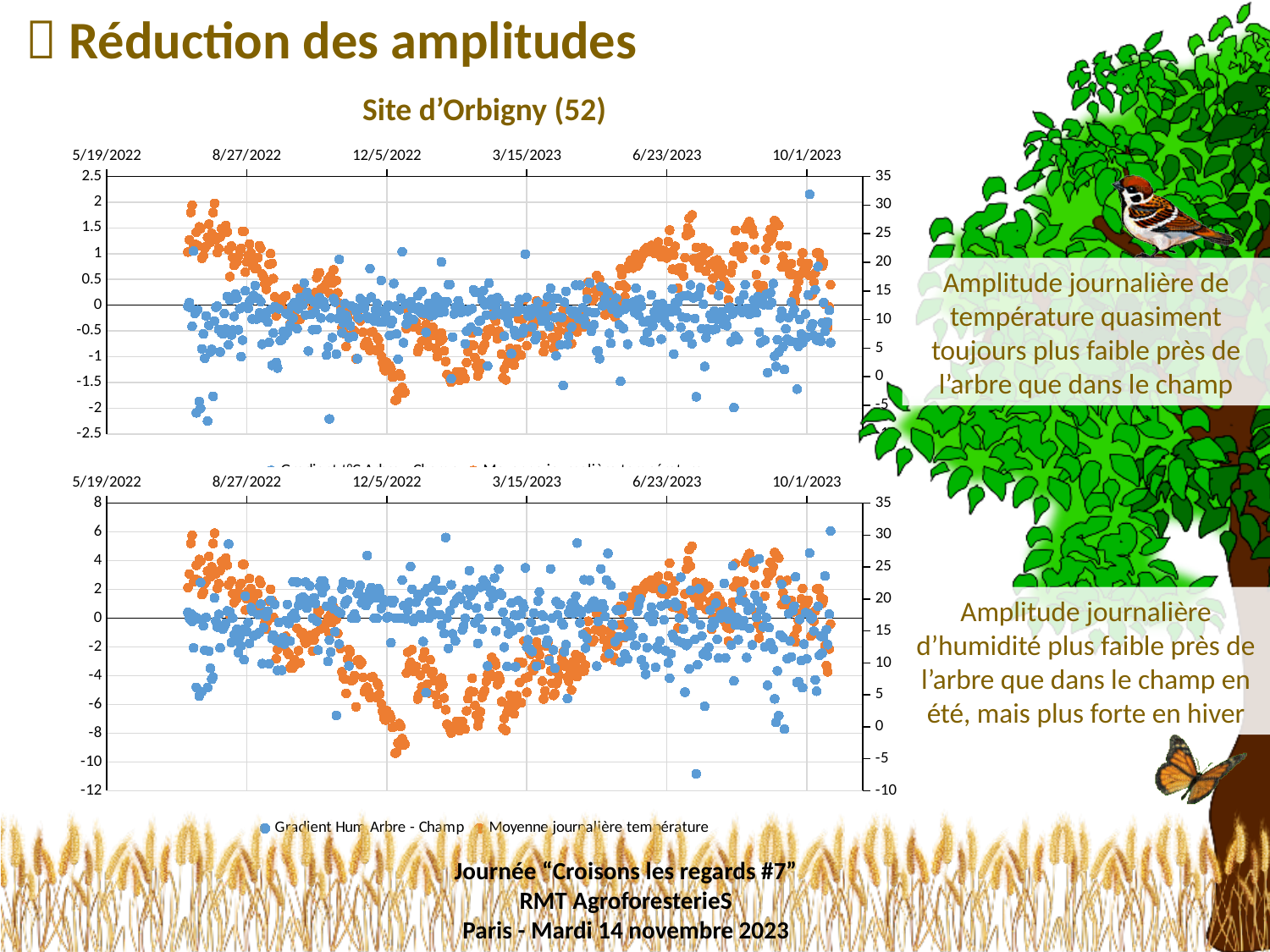
What kind of chart is the top chart on the slide? scatter chart In the bottom chart, what are the two legend entries? Gradient Hum Arbre - Champ; Moyenne journalière température In the bottom chart, what is the last date label on the x axis? 10/1/2023 What kind of chart is the bottom chart on the slide? scatter chart In the top chart, what is the first date label on the x axis? 5/19/2022 In the top chart, how many date labels are shown along the x axis? 6 In the bottom chart, how many series does the legend list? 2 In the top chart, is the highest value of the orange series (right axis) greater or less than 25? greater In the bottom chart, is the lowest value of the orange series (right axis) greater or less than 0? less In the bottom chart, what is the highest tick value on the right vertical axis? 35 In the bottom chart, what is the highest tick value on the left vertical axis? 8 What is the title shown above the charts? Site d'Orbigny (52)